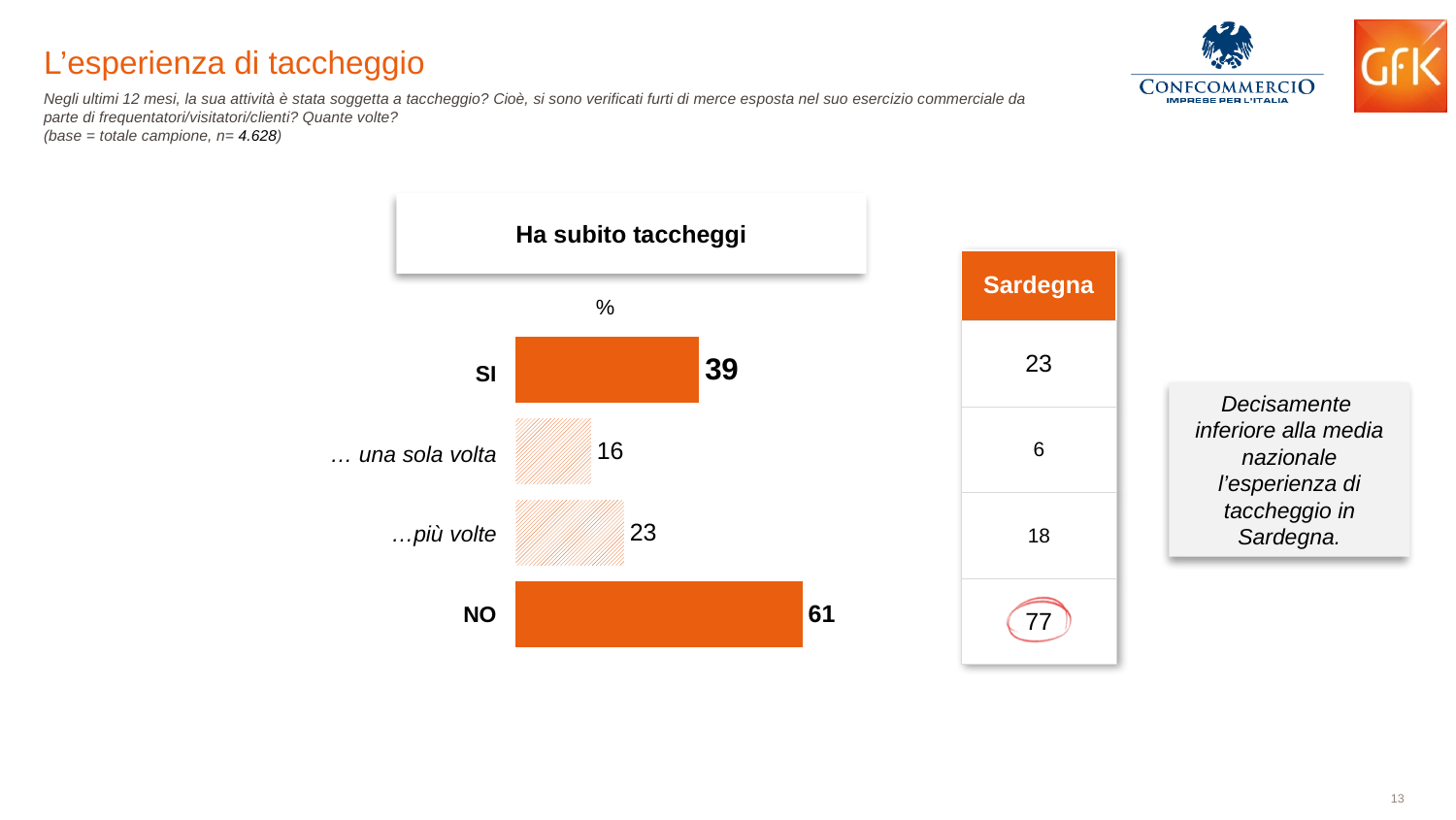
What kind of chart is 'Ha subito taccheggi'? Bar chart Which category has the lowest value in the 'Ha subito taccheggi' chart? … una sola volta What is the value for NO in the 'Ha subito taccheggi' chart? 61 What is the difference between the values for NO and SI in the 'Ha subito taccheggi' chart? 22 In the 'Ha subito taccheggi' chart, which is larger: '… una sola volta' or '…più volte'? …più volte What is the difference between '…più volte' and '… una sola volta' in the 'Ha subito taccheggi' chart? 7 Which category has the highest value in the 'Ha subito taccheggi' chart? NO What is the value for '…più volte' in the 'Ha subito taccheggi' chart? 23 How many categories are shown in the 'Ha subito taccheggi' chart? 4 What is the value for '… una sola volta' in the 'Ha subito taccheggi' chart? 16 What is the value for SI in the 'Ha subito taccheggi' chart? 39 What unit is indicated above the bars in the 'Ha subito taccheggi' chart? %